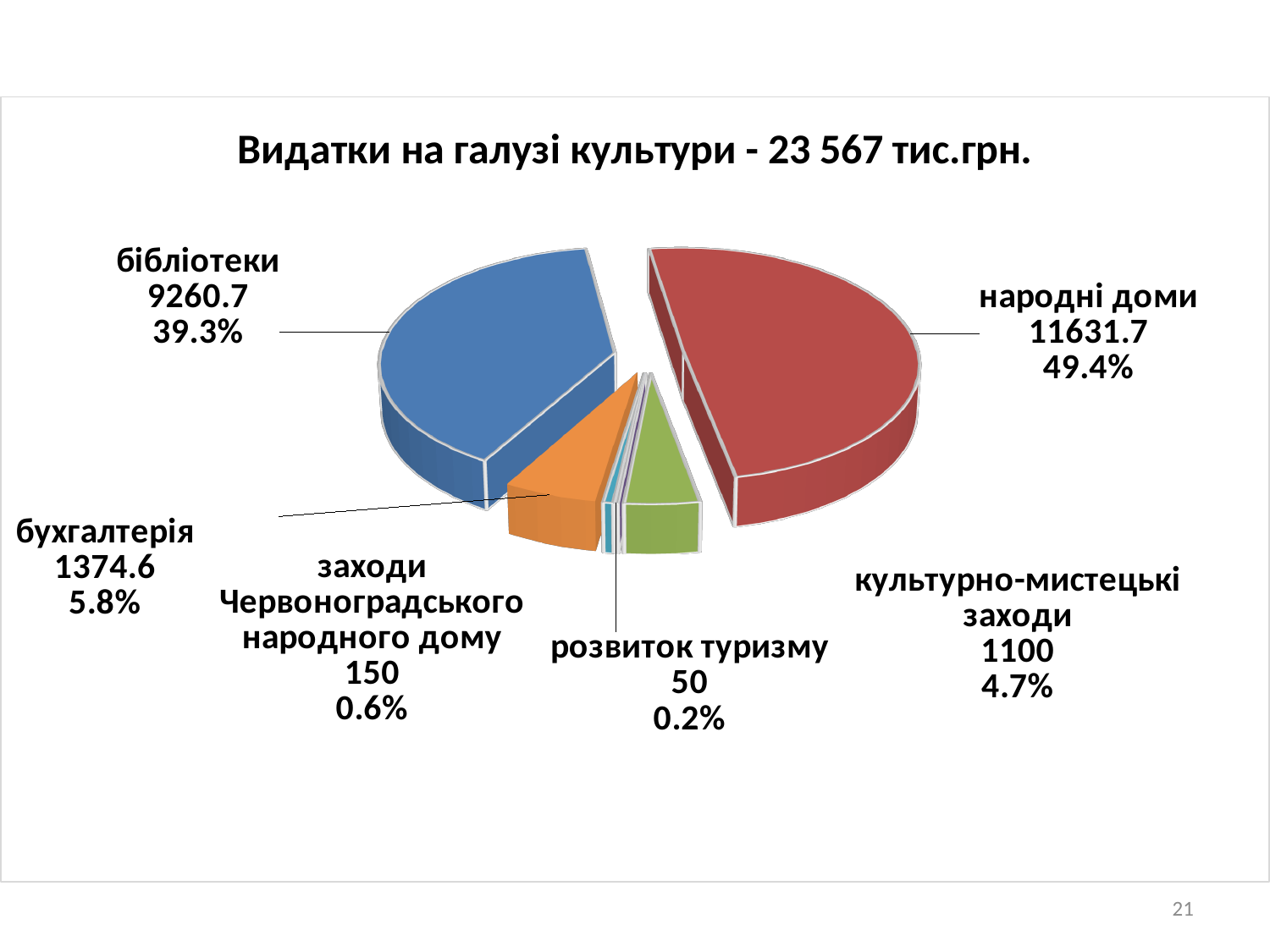
What kind of chart is shown on the slide? pie chart What share of the pie does заходи Червоноградського народного дому represent? 0.6% What is the value for народні доми? 11631.7 How many slices does the pie chart have? 6 What is the value for розвиток туризму? 50 Which is larger, бухгалтерія or культурно-мистецькі заходи? бухгалтерія What is the value for бібліотеки? 9260.7 Which category has the smallest slice? розвиток туризму What is the value for бухгалтерія? 1374.6 Which category has the largest slice? народні доми What is the title of the chart? Видатки на галузі культури - 23 567 тис.грн. What share of the pie does культурно-мистецькі заходи represent? 4.7%